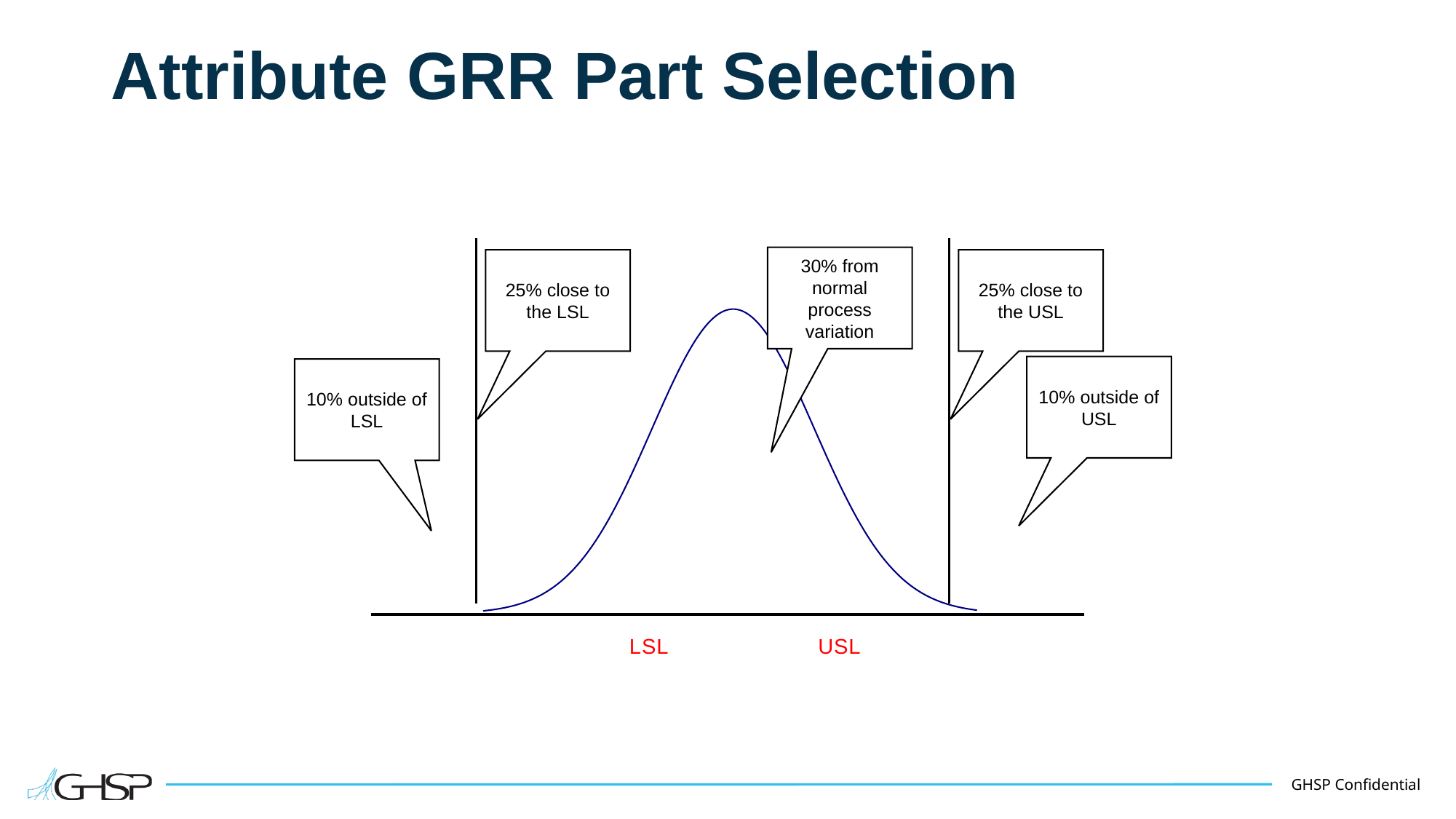
What percentage of parts should be outside of the LSL? 10% What is the lowest percentage shown in any callout on the diagram? 10% Which part selection category has the largest percentage? 30% from normal process variation What percentage of parts should be close to the LSL? 25% What percentage of parts should be outside of the USL? 10% How many part selection categories (callouts) are shown on the diagram? 5 Which is larger: the percentage close to the LSL or the percentage outside of the LSL? 25% close to the LSL What kind of curve is drawn between the two specification limit lines? A normal distribution (bell) curve What is the difference between the percentage from normal process variation and the percentage close to the USL? 5% What is the total of all the percentages shown in the callouts? 100% What percentage of parts should come from normal process variation? 30% What are the two labels printed in red below the horizontal axis? LSL and USL